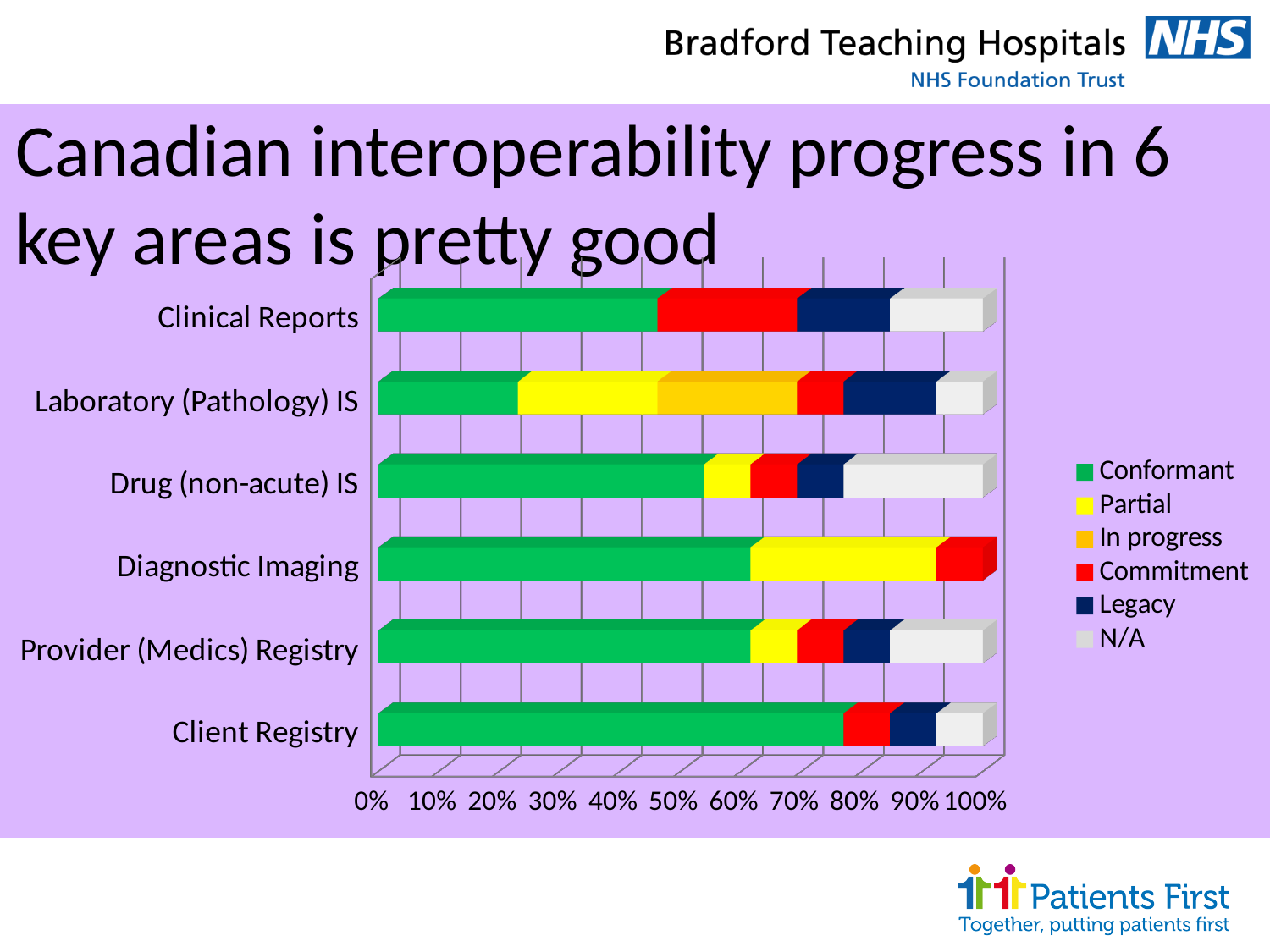
What is the total of the stacked bar for Diagnostic Imaging? 100% Which colour represents Conformant in the legend? Green How many categories (key areas) are plotted on the chart? 6 What kind of chart is shown on the slide? Stacked bar chart Which category is the only one with an In progress segment? Laboratory (Pathology) IS Is the Conformant share for Laboratory (Pathology) IS greater or less than 30%? less Which category has the smallest Conformant share? Laboratory (Pathology) IS Is the Conformant share for Client Registry greater or less than 70%? greater Which category has the largest Conformant share? Client Registry How many series does the chart legend list? 6 Is the Conformant share for Clinical Reports greater or less than 50%? less Which has the larger Conformant share, Drug (non-acute) IS or Laboratory (Pathology) IS? Drug (non-acute) IS